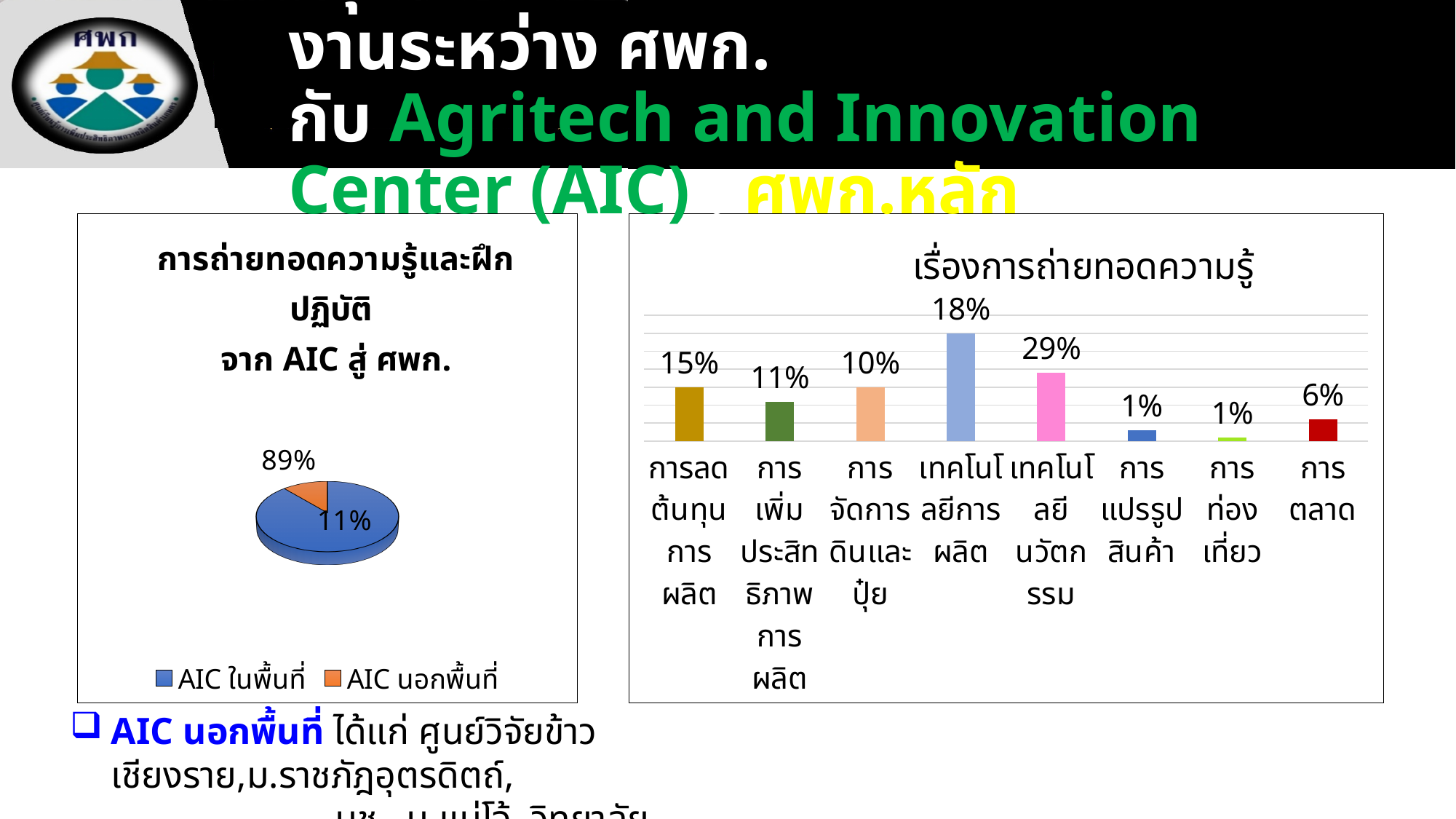
How many categories are shown in the bar chart titled เรื่องการถ่ายทอดความรู้? 8 How many entries does the legend of the pie chart on the left list? 2 In the pie chart on the left, what share does AIC นอกพื้นที่ have? 11% In the bar chart titled เรื่องการถ่ายทอดความรู้, what is the value for การตลาด? 6% In the pie chart on the left, which slice is larger: AIC ในพื้นที่ or AIC นอกพื้นที่? AIC ในพื้นที่ In the bar chart titled เรื่องการถ่ายทอดความรู้, what is the value for การลดต้นทุนการผลิต? 15% What kind of chart is the chart on the left titled การถ่ายทอดความรู้และฝึกปฏิบัติ จาก AIC สู่ ศพก.? Pie chart In the bar chart titled เรื่องการถ่ายทอดความรู้, what is the difference between เทคโนโลยีนวัตกรรม and เทคโนโลยีการผลิต? 11% In the bar chart titled เรื่องการถ่ายทอดความรู้, what is the value for เทคโนโลยีนวัตกรรม? 29% What kind of chart is the chart on the right titled เรื่องการถ่ายทอดความรู้? Bar chart